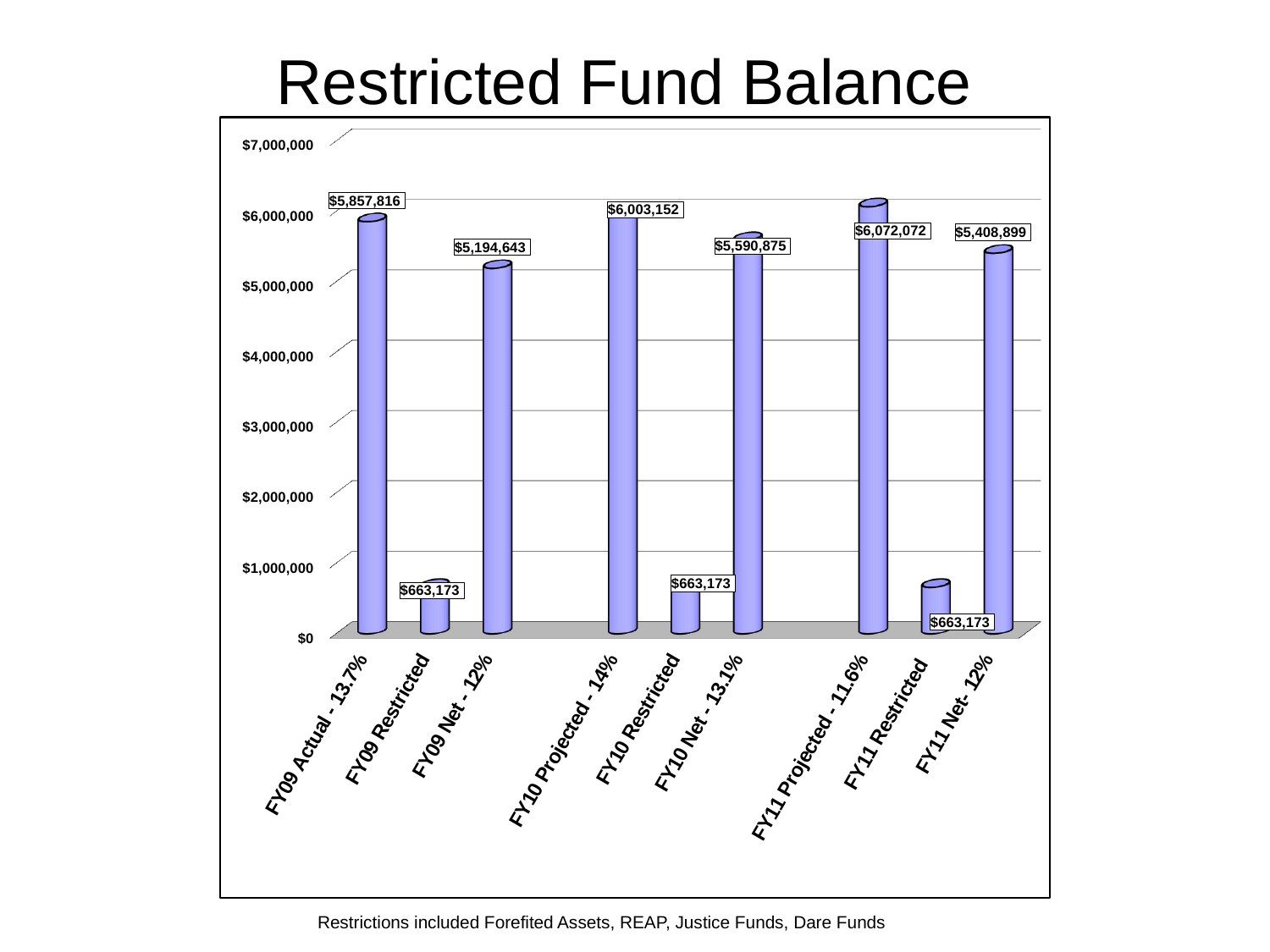
What is the title of the chart? Restricted Fund Balance What kind of chart is shown on the slide? bar chart What is the value for FY10 Restricted? $663,173 What is the value for FY09 Actual - 13.7%? $5,857,816 What is the difference between FY10 Net - 13.1% and FY09 Net - 12%? $396,232 Which is larger, FY10 Net - 13.1% or FY11 Net- 12%? FY10 Net - 13.1% What is the difference between FY09 Actual - 13.7% and FY09 Restricted? $5,194,643 Is the value for FY09 Net - 12% greater or less than $5,000,000? greater What is the value for FY11 Net- 12%? $5,408,899 Which category has the highest value? FY11 Projected - 11.6% What is the value for FY10 Projected - 14%? $6,003,152 How many bars are shown in the chart? 9